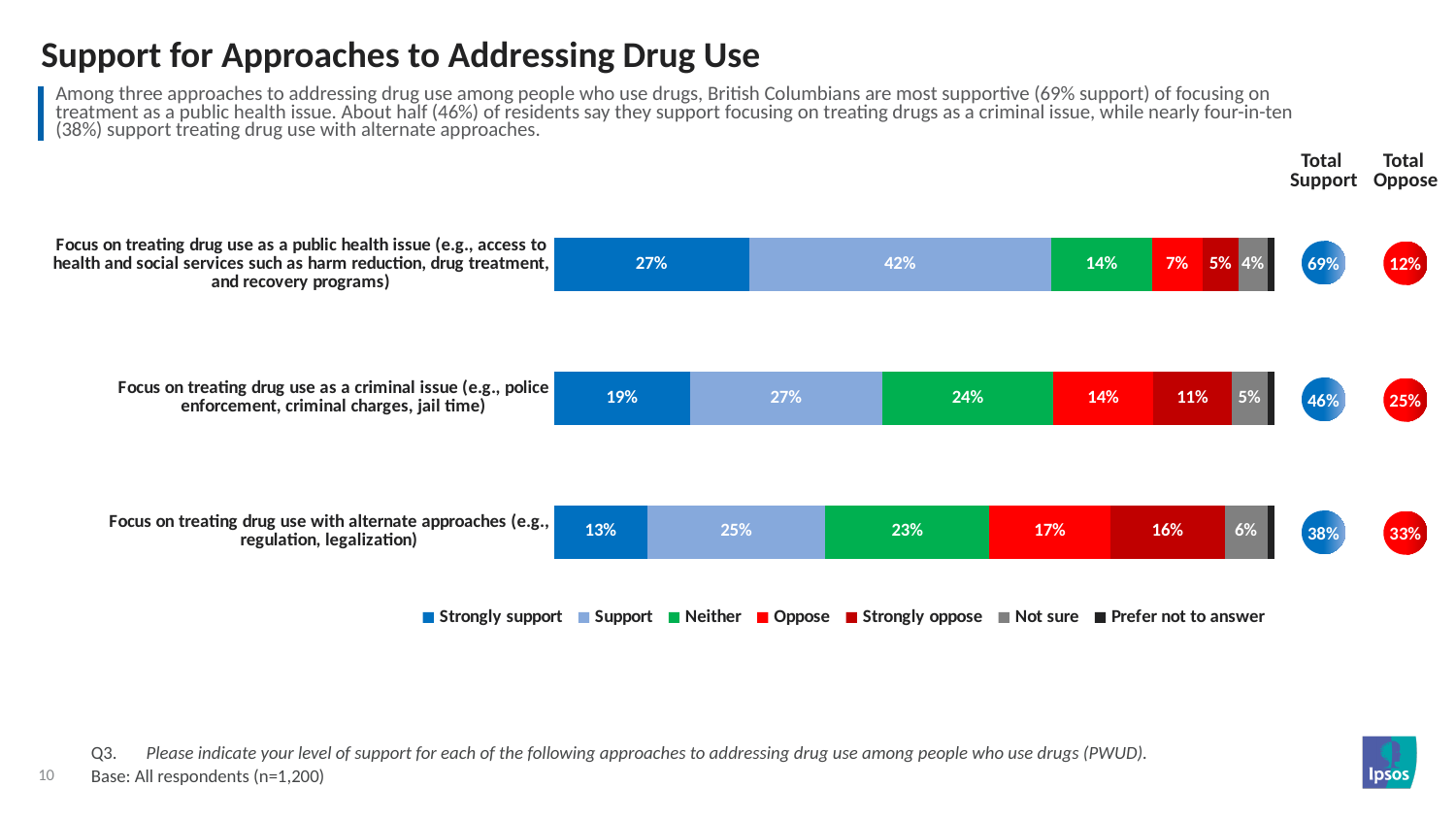
What is the Total Support for focusing on treating drug use as a criminal issue? 46% What percentage strongly oppose treating drug use with alternate approaches (e.g., regulation, legalization)? 16% How many percentage points higher is the 'Support' value for the public health issue approach than for the alternate approaches? 17 percentage points Which approach has the highest 'Strongly support' percentage? Focus on treating drug use as a public health issue What is the 'Support' value for focusing on treating drug use as a criminal issue? 27% How many response categories does the legend list? 7 What colour represents 'Neither' in the legend? Green How many approaches (bars) are shown in the chart? 3 Which has a larger 'Oppose' percentage: the criminal issue approach or the alternate approaches? Alternate approaches What percentage of respondents strongly support focusing on treating drug use as a public health issue? 27% What type of chart is shown on the slide? Stacked bar chart Which approach has the lowest 'Strongly support' percentage? Focus on treating drug use with alternate approaches